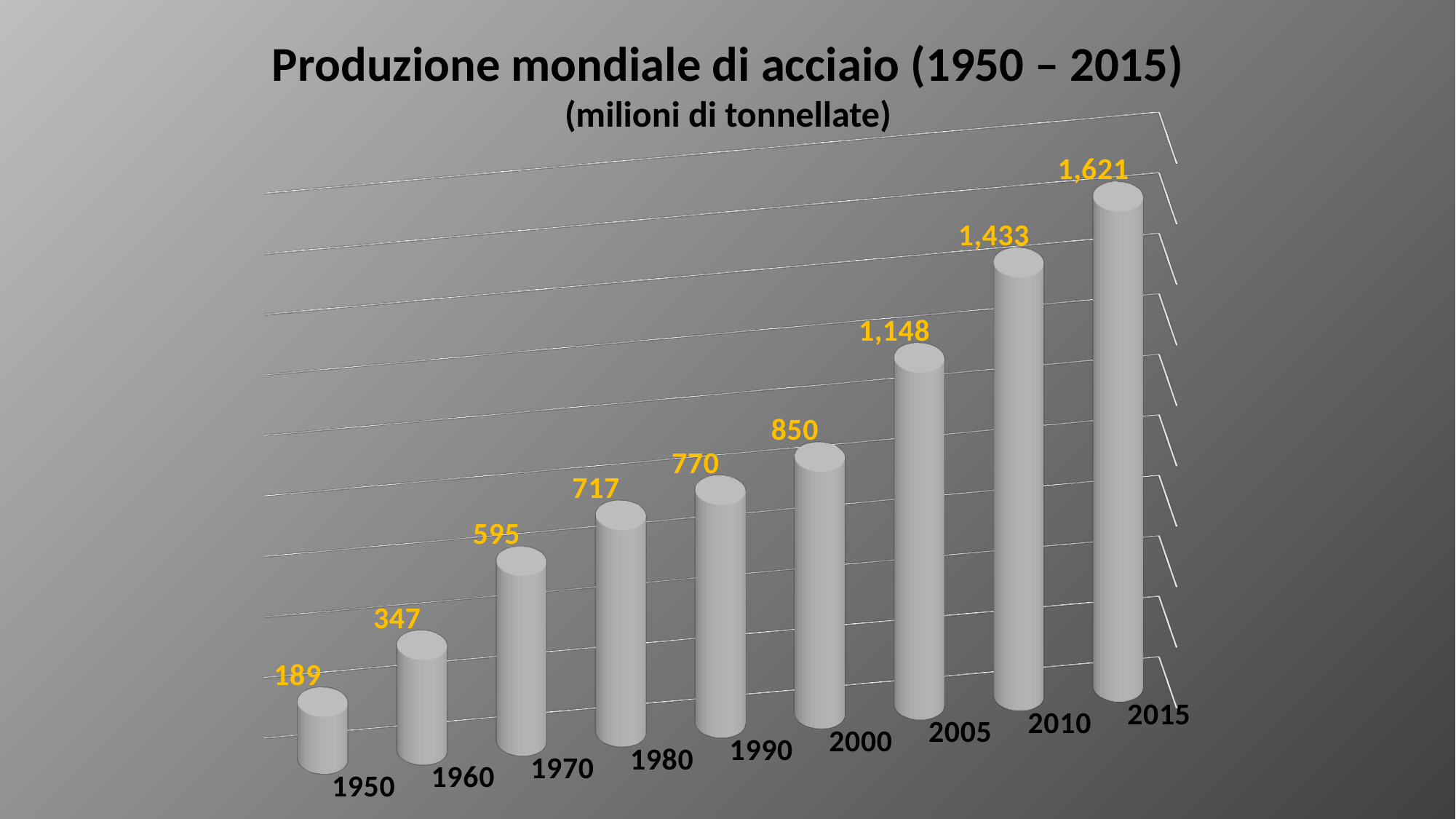
What is the value for 1990? 770 What is the title of the chart? Produzione mondiale di acciaio (1950 – 2015) What kind of chart is this? bar chart Do the values rise or fall from 1950 to 2015? rise What is the difference between the values for 2010 and 2005? 285 Which year has the lowest value? 1950 What is the value for 1950? 189 How many years are shown on the chart? 9 What is the value for 2015? 1,621 Which is larger, the value for 1980 or the value for 1970? 1980 What is the difference between the values for 1960 and 1950? 158 Which year has the highest value? 2015